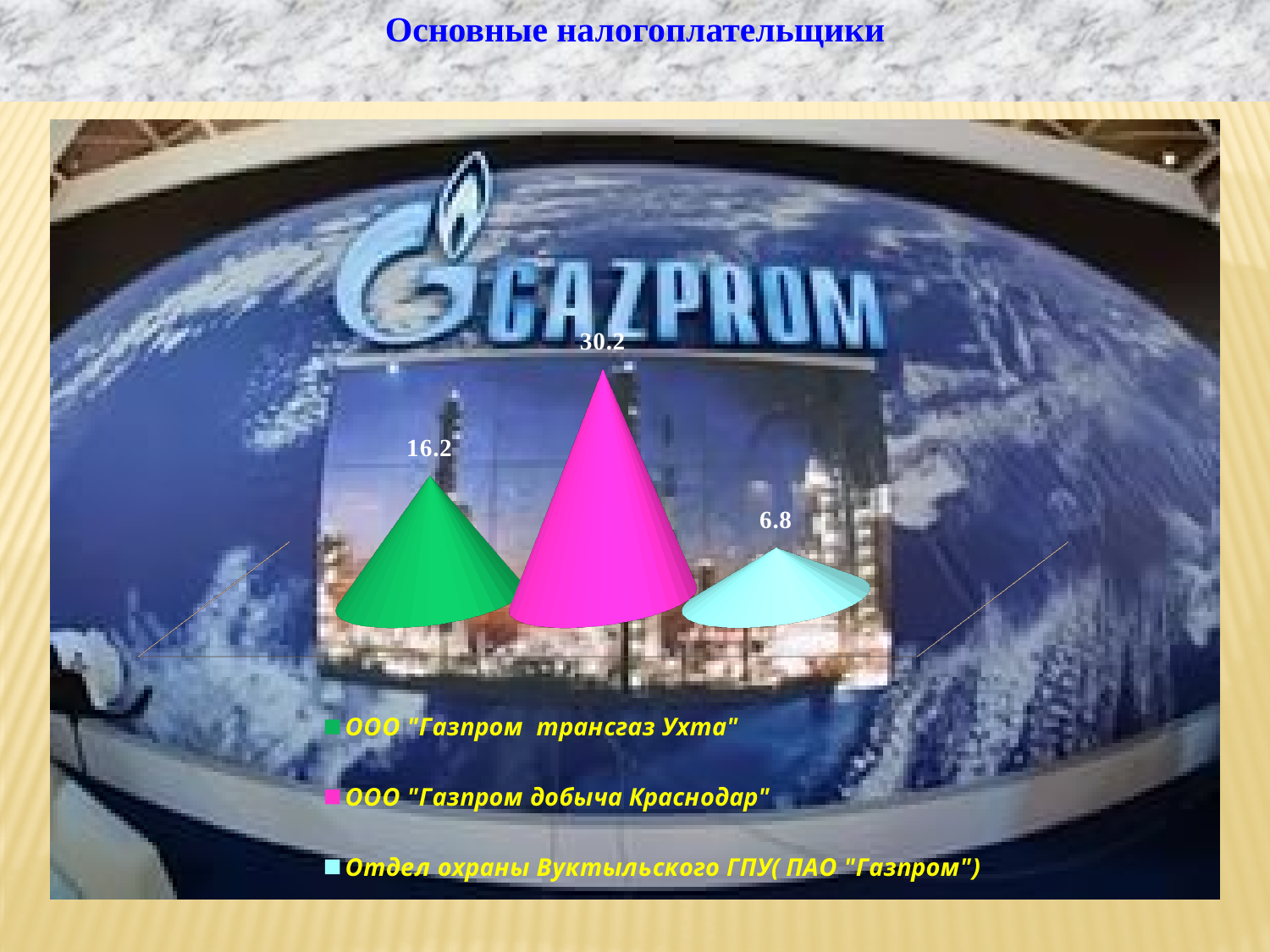
Which is larger: the value for ООО "Газпром трансгаз Ухта" or the value for Отдел охраны Вуктыльского ГПУ( ПАО "Газпром")? ООО "Газпром трансгаз Ухта" Which taxpayer has the lowest value? Отдел охраны Вуктыльского ГПУ( ПАО "Газпром") What is the title of the slide? Основные налогоплательщики What is the difference between the values for ООО "Газпром добыча Краснодар" and ООО "Газпром трансгаз Ухта"? 14 Which taxpayer has the highest value? ООО "Газпром добыча Краснодар" What kind of chart is shown on the slide? Bar chart What is the difference between the values for ООО "Газпром трансгаз Ухта" and Отдел охраны Вуктыльского ГПУ( ПАО "Газпром")? 9.4 What is the value for Отдел охраны Вуктыльского ГПУ( ПАО "Газпром")? 6.8 What is the value for ООО "Газпром трансгаз Ухта"? 16.2 How many entries does the legend list? 3 How many taxpayers are plotted on the chart? 3 What is the value for ООО "Газпром добыча Краснодар"? 30.2